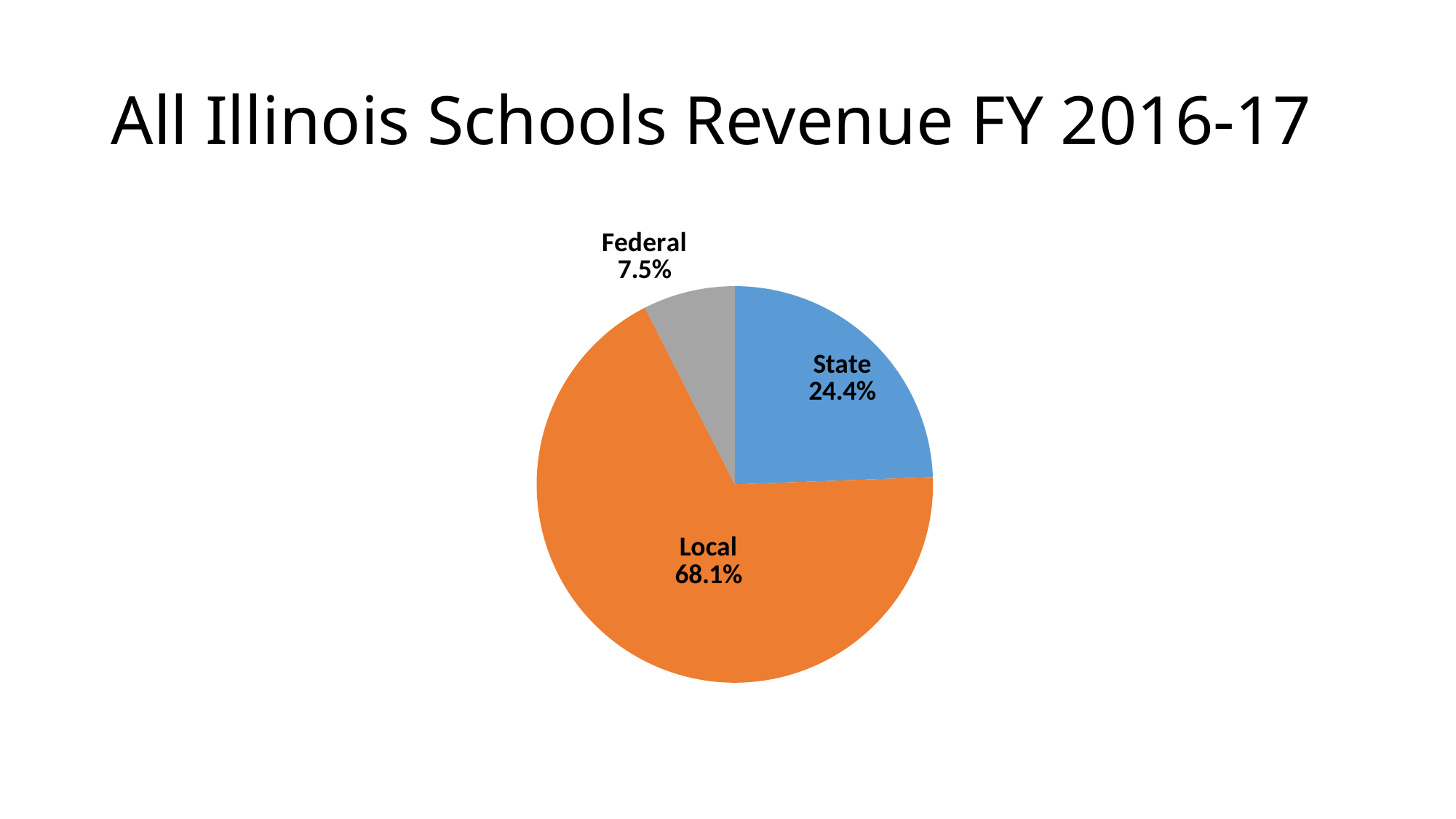
What kind of chart is shown on the slide? Pie chart What share of revenue comes from State sources? 24.4% What share of revenue comes from Local sources? 68.1% Which revenue source has the smallest share? Federal Which revenue source has the largest share? Local What is the title of the chart? All Illinois Schools Revenue FY 2016-17 What colour is the Local slice of the pie? Orange What share of revenue comes from Federal sources? 7.5% Which is larger, the State share or the Federal share? State How many revenue sources are shown in the pie chart? 3 What is the difference in percentage points between the State and Federal shares? 16.9 What is the difference in percentage points between the Local and State shares? 43.7